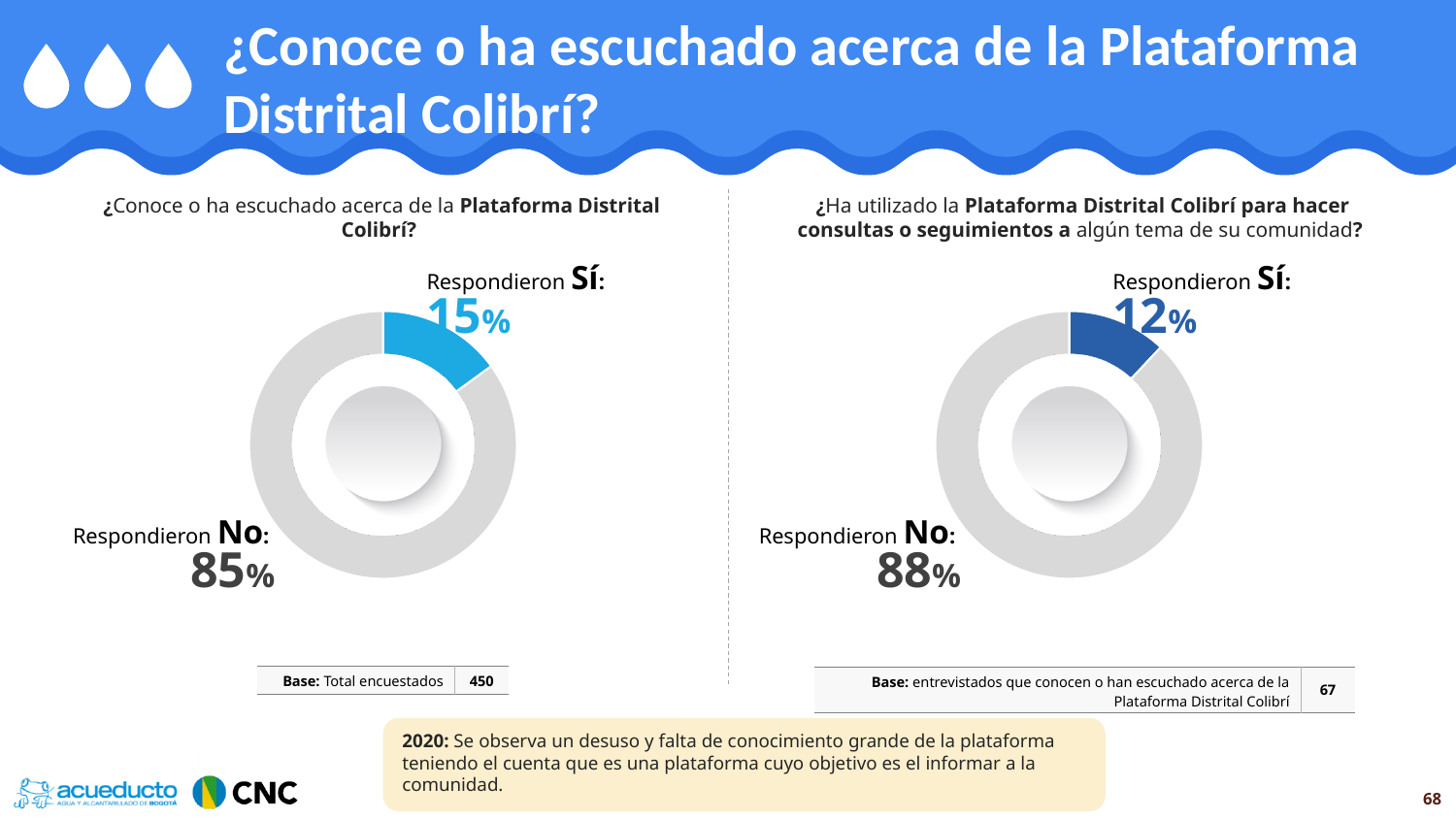
How many response categories does each chart on the slide show? 2 In the right chart (¿Ha utilizado la Plataforma Distrital Colibrí para hacer consultas o seguimientos?), what percentage responded Sí? 12% Is the Sí share in the left chart larger or smaller than the Sí share in the right chart? larger What is the base (number of respondents) for the right chart? 67 In the left chart, what is the difference between the No and Sí percentages? 70% In the left chart (¿Conoce o ha escuchado acerca de la Plataforma Distrital Colibrí?), what percentage responded No? 85% In the left chart, which response has the larger share, Sí or No? No In the right chart, which response has the smaller share, Sí or No? Sí In the left chart (¿Conoce o ha escuchado acerca de la Plataforma Distrital Colibrí?), what percentage responded Sí? 15% In the right chart, what is the difference between the No and Sí percentages? 76% What type of chart is used on the left side of the slide? Donut (pie) chart In the right chart (¿Ha utilizado la Plataforma Distrital Colibrí para hacer consultas o seguimientos?), what percentage responded No? 88%